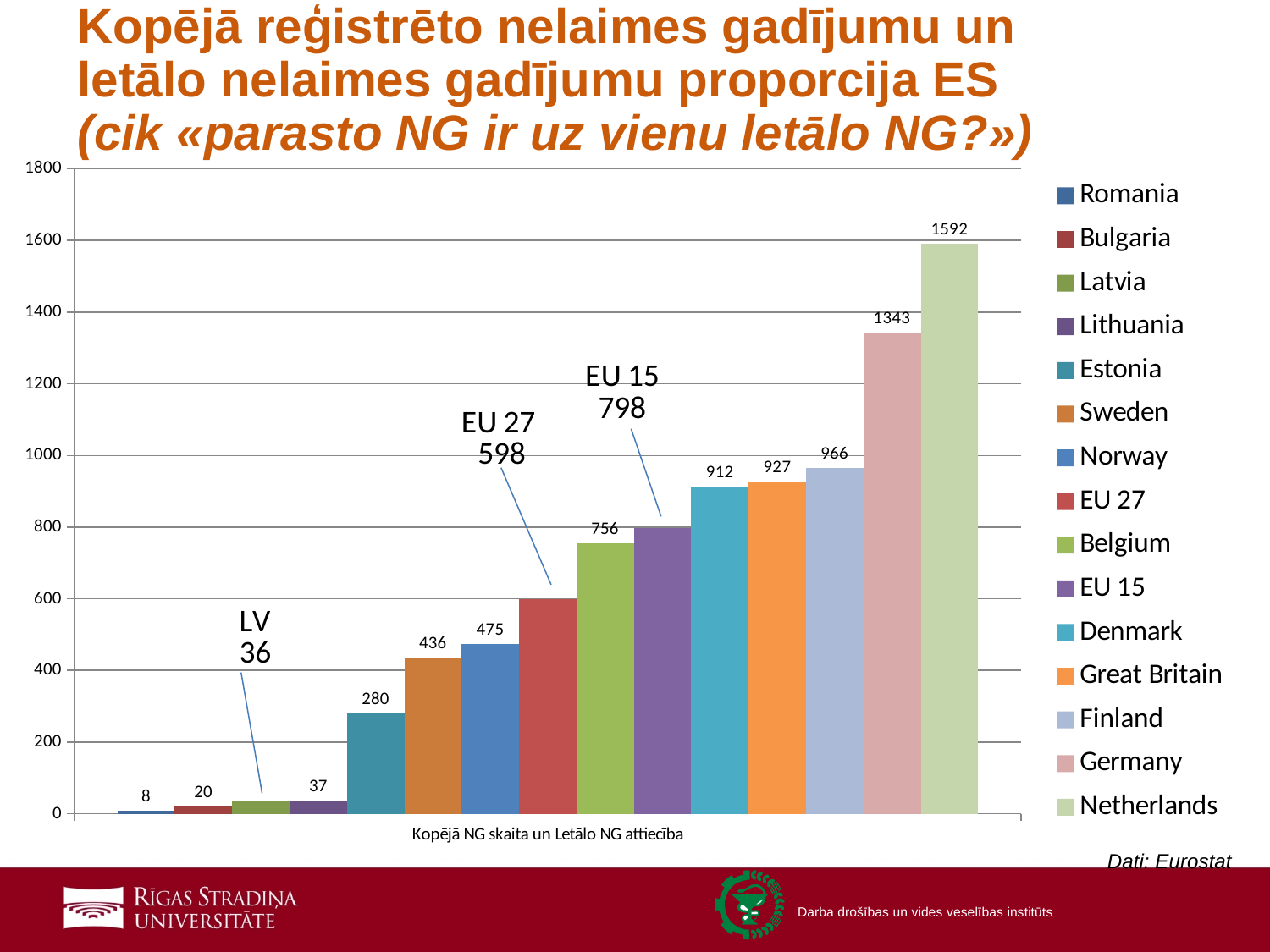
What is the difference between the values for Netherlands and Germany? 249 Which country has the lowest value in the chart? Romania What value is annotated for EU 15? 798 Do the bar values rise or fall from left to right along the x axis? Rise What is the value for Germany? 1343 Which is larger, the value for Finland or the value for Great Britain? Finland What value is annotated for EU 27? 598 What is the value for Estonia? 280 Which country has the highest value in the chart? Netherlands How many series does the legend list? 15 What is the value for Netherlands? 1592 What kind of chart is shown on the slide? Bar chart